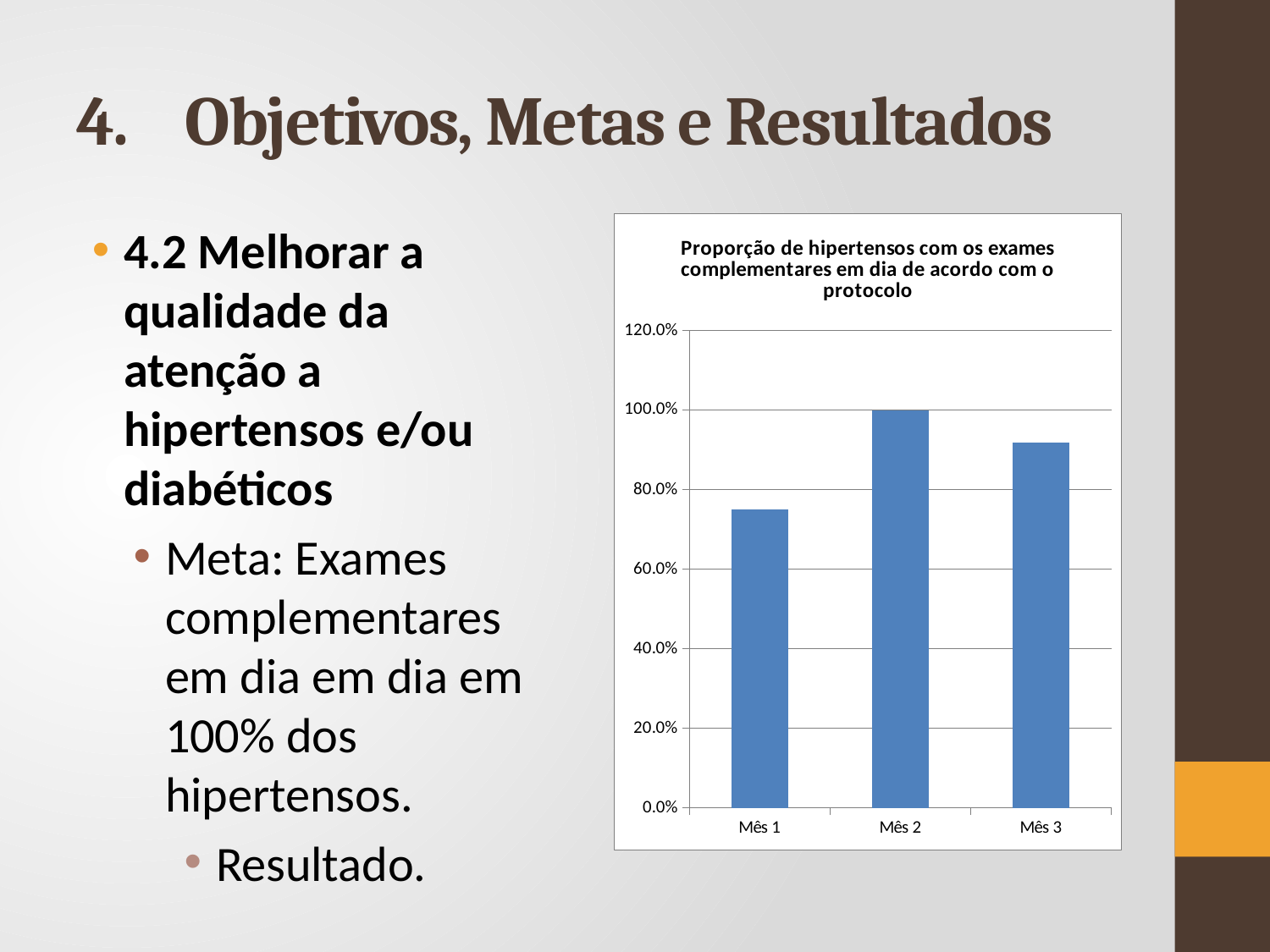
Which month has the highest proportion of hypertensive patients with up-to-date complementary exams? Mês 2 Is the value for Mês 1 greater or less than 80.0%? less What kind of chart is shown on the slide? bar chart Is the value for Mês 1 greater or less than 60.0%? greater Is the value for Mês 3 greater or less than 100.0%? less What is the value for Mês 2 on the chart? 100.0% How many months (categories) are plotted on the chart? 3 Which is larger, the value for Mês 1 or the value for Mês 3? Mês 3 What is the highest tick value shown on the vertical axis of the chart? 120.0% Which month has the lowest value on the chart? Mês 1 Does the value rise or fall from Mês 2 to Mês 3? fall